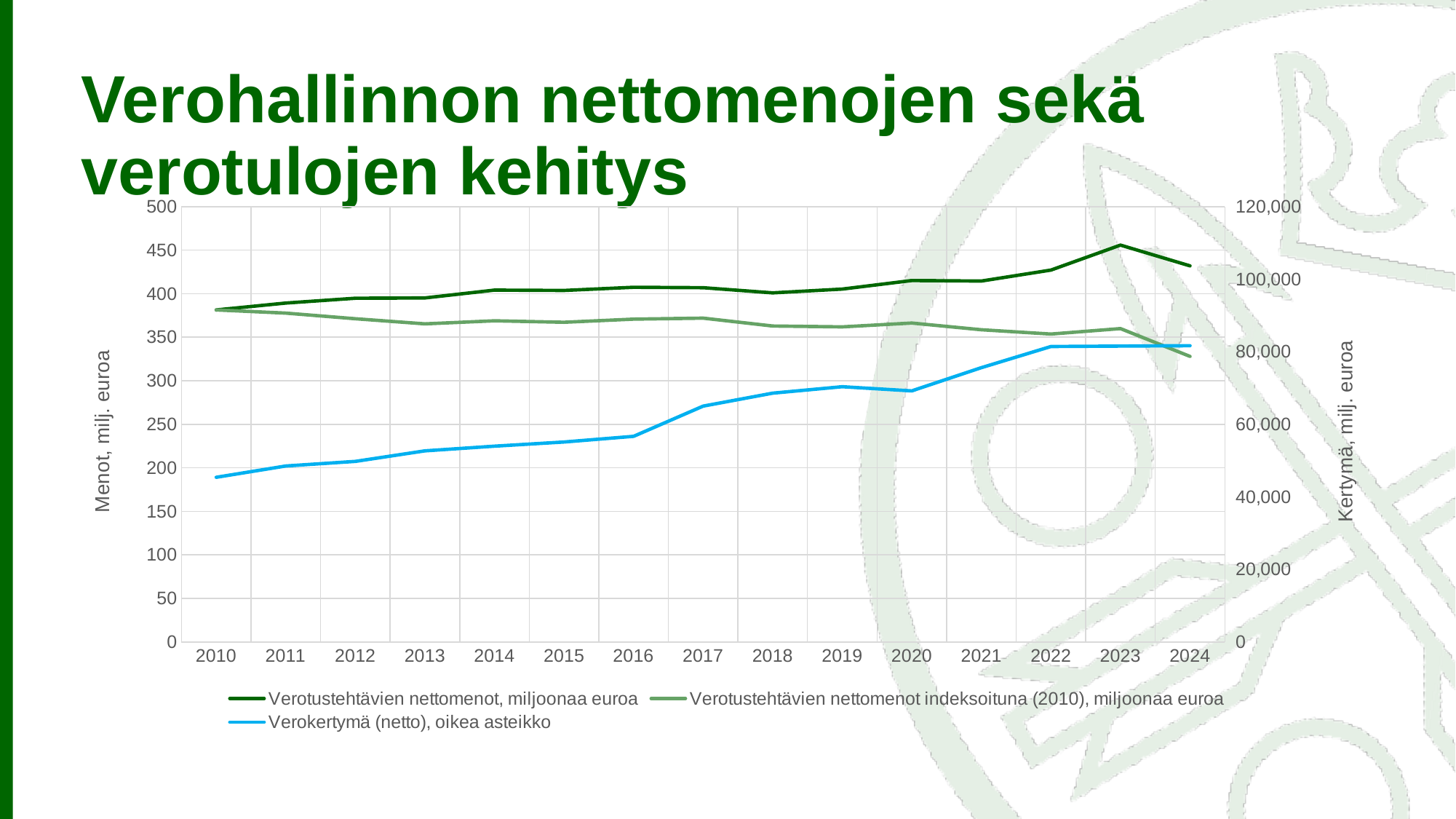
Is the value for 'Verotustehtävien nettomenot, miljoonaa euroa' in 2010 greater or less than 400? less What kind of chart is shown on the slide? line chart In which year is the series 'Verotustehtävien nettomenot indeksoituna (2010), miljoonaa euroa' at its lowest? 2024 What is the first year shown on the x axis? 2010 Does the series 'Verokertymä (netto), oikea asteikko' generally rise or fall from 2010 to 2024? rise How many years are plotted along the x axis? 15 How many series does the legend list? 3 What is the title of the left vertical axis? Menot, milj. euroa Is the value for 'Verokertymä (netto), oikea asteikko' in 2024 greater or less than 60,000? greater In which year does the series 'Verotustehtävien nettomenot, miljoonaa euroa' reach its highest value? 2023 In 2024, which series is higher: 'Verotustehtävien nettomenot, miljoonaa euroa' or 'Verotustehtävien nettomenot indeksoituna (2010), miljoonaa euroa'? Verotustehtävien nettomenot, miljoonaa euroa In which year is the series 'Verokertymä (netto), oikea asteikko' at its lowest? 2010